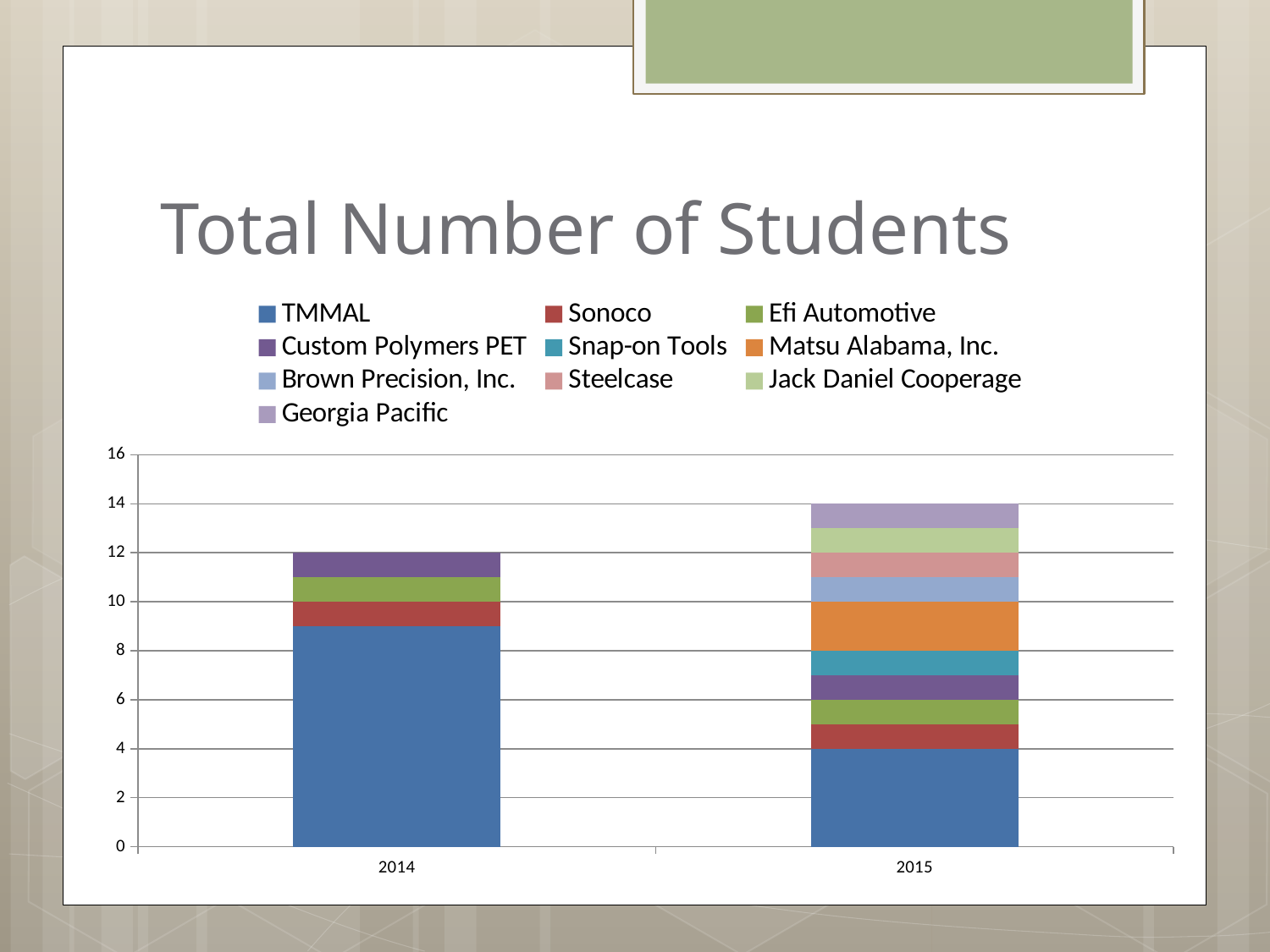
How many years are shown on the x axis of the chart? 2 What kind of chart is shown on the slide? bar chart Which year has the larger total number of students, 2014 or 2015? 2015 Which series is shown in blue at the bottom of each stacked bar? TMMAL Is the value for TMMAL in 2015 greater or less than 6? less How many series does the legend list? 10 What is the difference between the total for 2015 and the total for 2014? 2 What is the total height of the stacked bar for 2015? 14 What is the total height of the stacked bar for 2014? 12 Is the value for TMMAL in 2014 greater or less than 8? greater Does the total number of students rise or fall from 2014 to 2015? rise What is the title of the chart? Total Number of Students